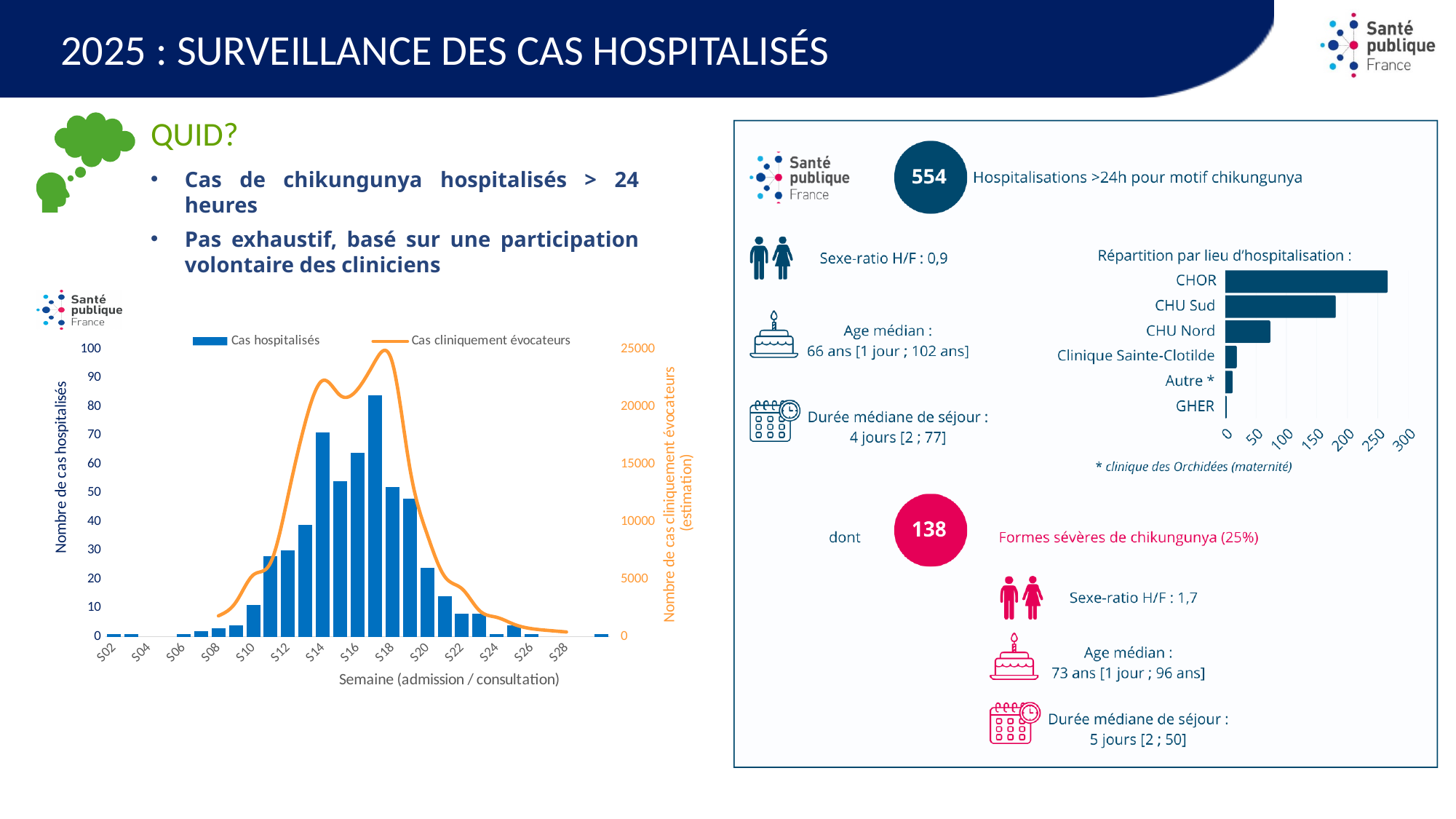
In the 'Répartition par lieu d'hospitalisation' chart, which is larger, CHU Sud or CHU Nord? CHU Sud In the 'Répartition par lieu d'hospitalisation' chart, which hospital location has the highest bar? CHOR In the weekly chart on the left, is the number of 'Cas hospitalisés' for S14 greater or less than 60? greater How many hospital locations are listed in the 'Répartition par lieu d'hospitalisation' chart? 6 What is the x-axis title of the weekly chart on the left? Semaine (admission / consultation) What kind of chart is the 'Répartition par lieu d'hospitalisation' chart? bar chart In the weekly chart on the left, which week has the highest bar for 'Cas hospitalisés'? S17 In the 'Répartition par lieu d'hospitalisation' chart, is the value for CHOR greater or less than 200? greater How many series does the legend of the weekly chart on the left list? 2 In the 'Répartition par lieu d'hospitalisation' chart, is the value for CHU Nord greater or less than 100? less In the 'Répartition par lieu d'hospitalisation' chart, which hospital location has the lowest bar? GHER